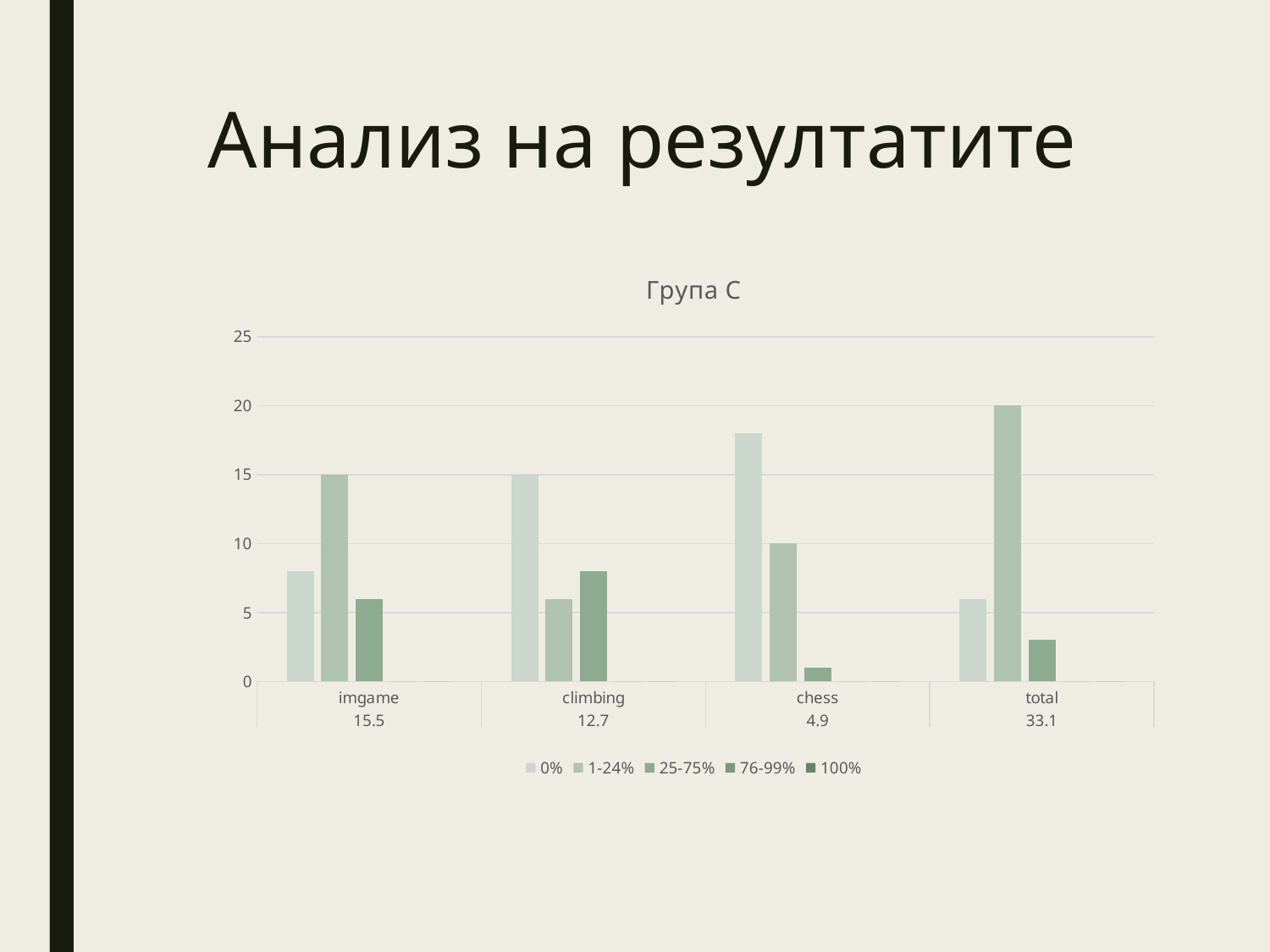
How many series does the legend of the chart list? 5 What is the value of the 1-24% series for imgame? 15 What is the value of the 1-24% series for chess? 10 Is the value of the 0% series for chess greater or less than 15? greater What is the value of the 1-24% series for total? 20 Which category has the highest value in the 1-24% series? total What kind of chart is shown on the slide? bar chart What is the value of the 0% series for climbing? 15 Is the value of the 25-75% series for total greater or less than 5? less How many categories are shown along the x axis of the chart? 4 What is the difference between the 1-24% values for total and chess? 10 What is the title of the chart? Група С